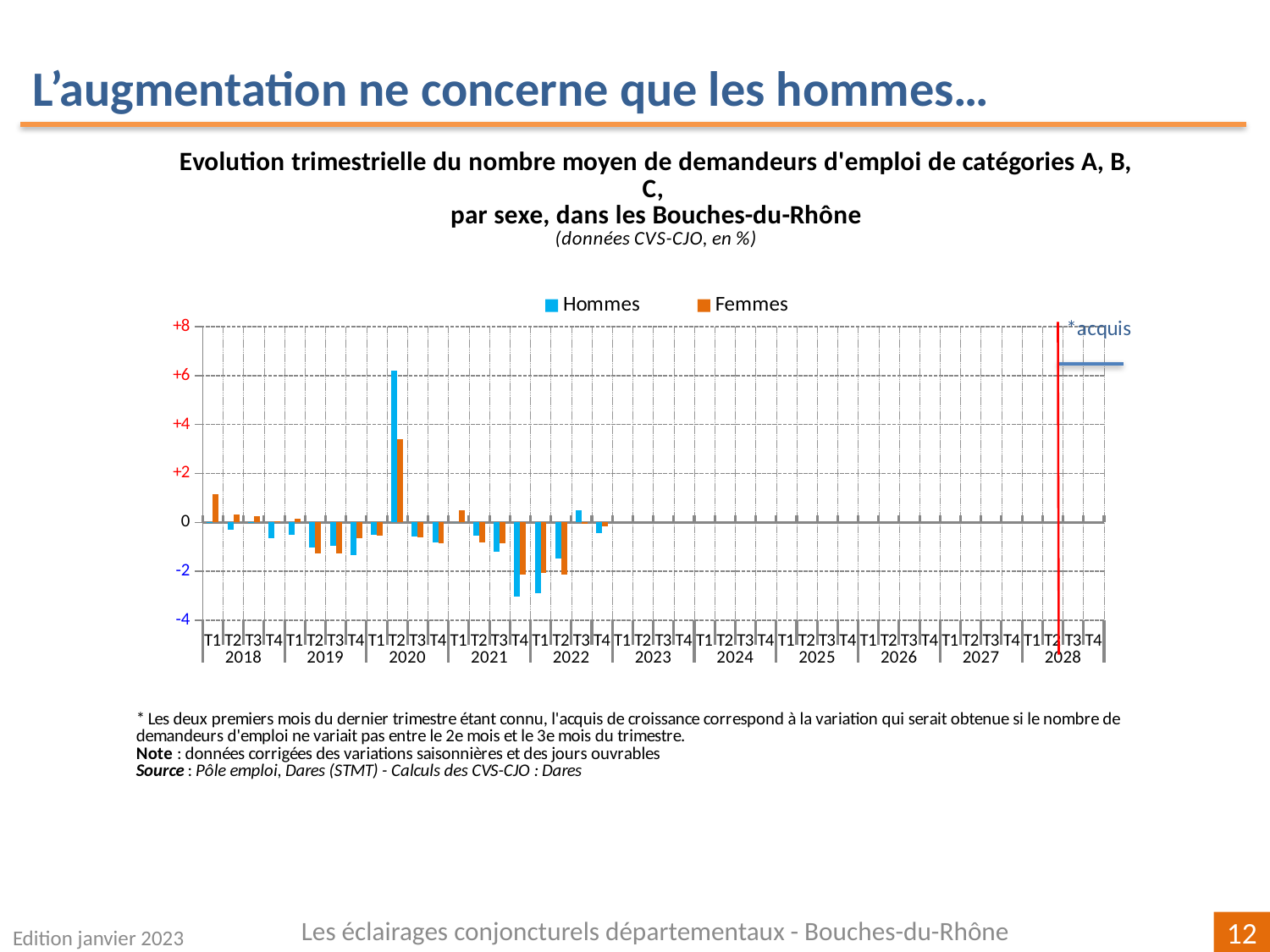
Is the Femmes value for T1 2018 greater or less than 0? greater What kind of chart is shown on the slide? bar chart Is the Hommes value for T4 2021 greater or less than -2? less How many years are labelled along the x axis of the chart? 11 Which two series are listed in the chart legend? Hommes and Femmes Is the Hommes value for T2 2020 greater or less than +4? greater In T2 2020, which series has the larger value, Hommes or Femmes? Hommes In which quarter does the Hommes series reach its highest value? T2 2020 Which is larger: the Hommes value for T2 2020 or the Femmes value for T1 2018? Hommes value for T2 2020 Which colour represents the Femmes series in the chart? orange How many series does the legend list? 2